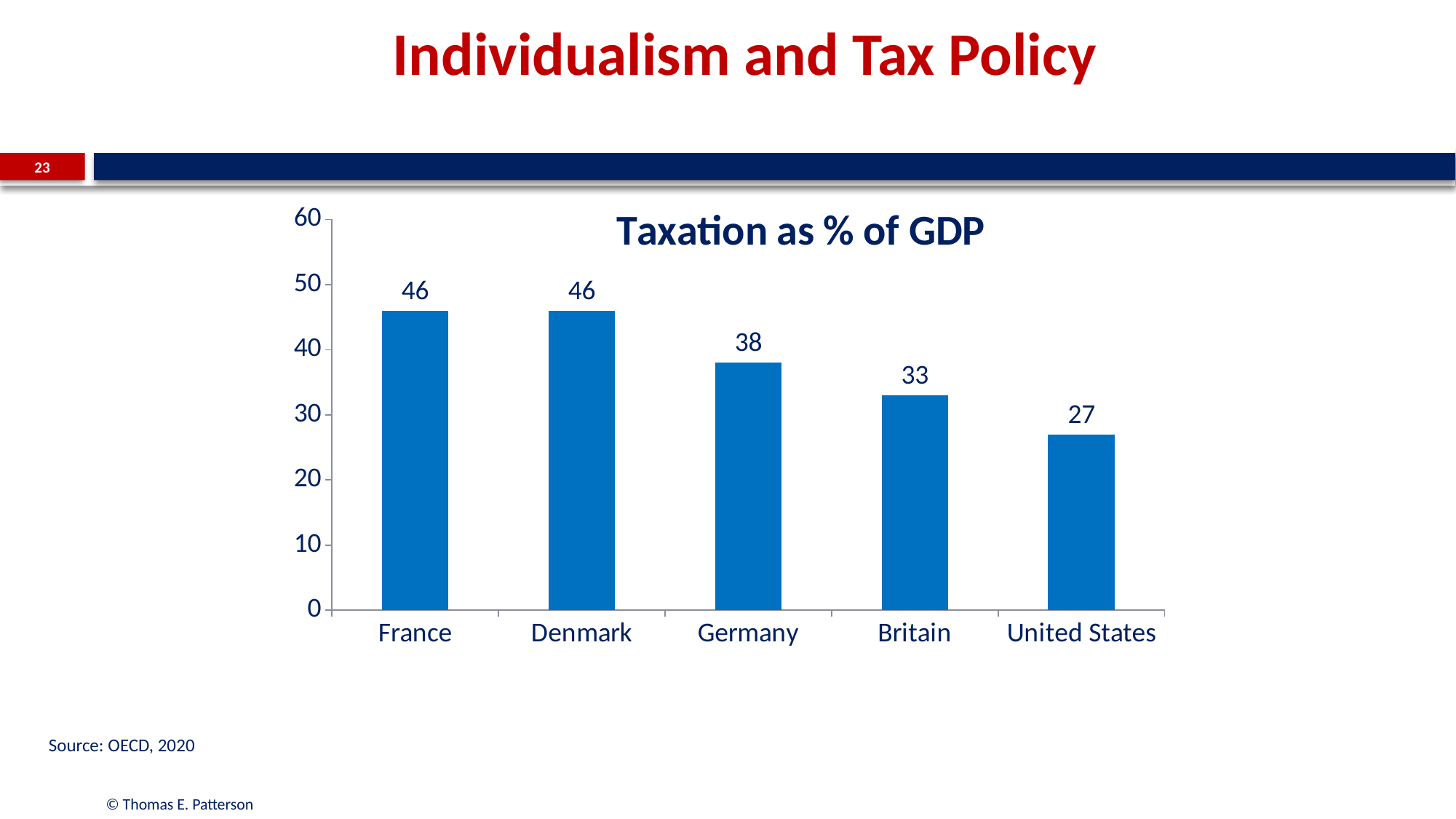
What is the value for Britain? 33 Is the value for Denmark greater or less than 40? greater Which country has the lowest taxation as % of GDP? United States What is the title of the chart? Taxation as % of GDP Which is larger, the value for Germany or the value for Britain? Germany What kind of chart is shown on the slide? Bar chart What is the difference between the values for France and the United States? 19 What is the difference between the values for Germany and Britain? 5 How many countries are shown in the chart? 5 Do the values rise or fall from left to right across the chart? Fall What is the value for the United States? 27 What is the value for Germany? 38